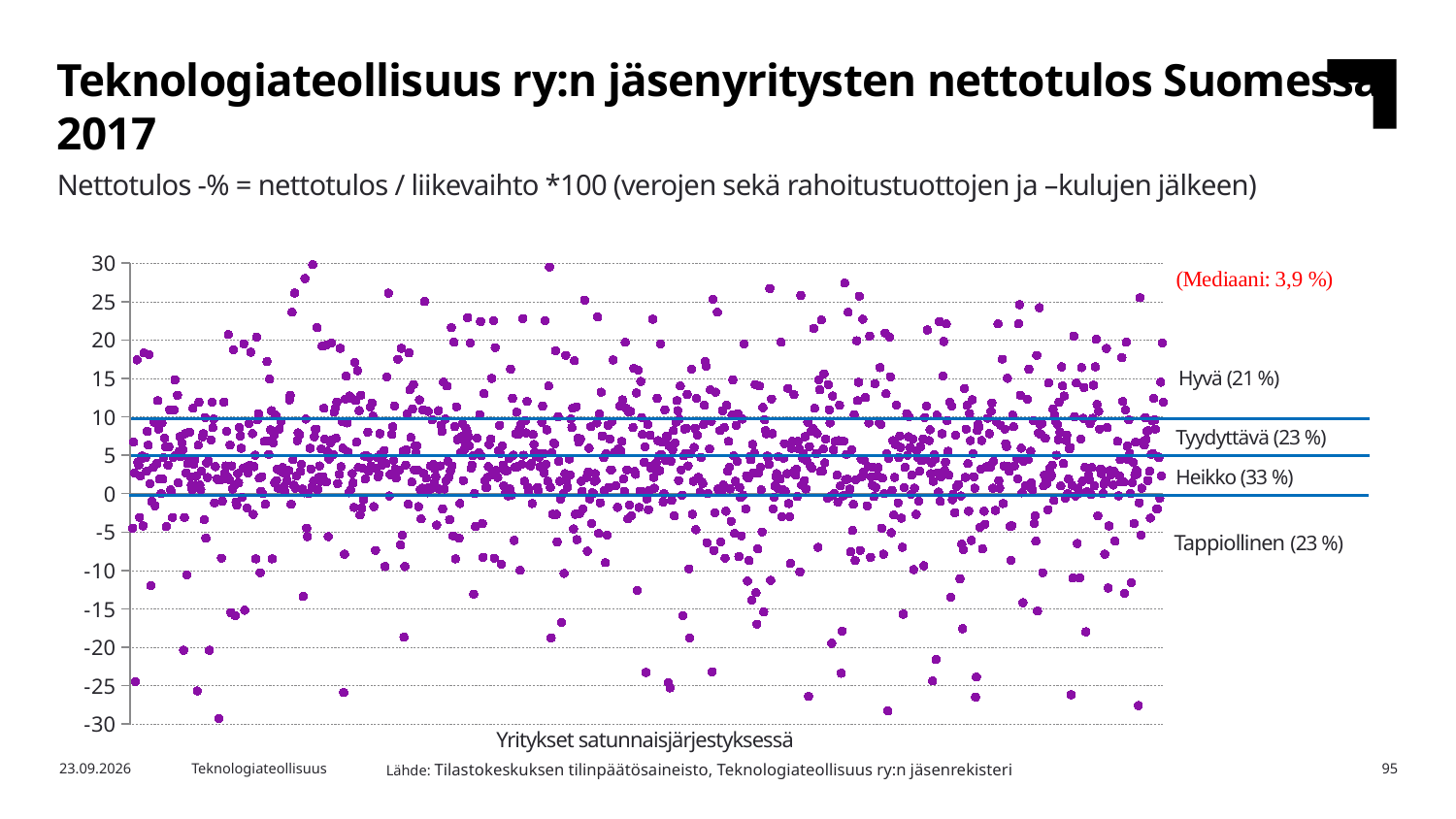
What is the highest value shown on the vertical axis? 30 What share of companies falls into the 'Hyvä' category? 21 % Which category has the smallest share of companies? Hyvä Which category has the largest share of companies? Heikko What kind of chart is shown on the slide? Scatter chart What is the median net profit percentage stated on the chart? 3,9 % What share of companies falls into the 'Tyydyttävä' category? 23 % Which share is larger, 'Heikko' or 'Tappiollinen'? Heikko How many percentage points larger is the 'Heikko' share than the 'Hyvä' share? 12 What share of companies falls into the 'Heikko' category? 33 % What is the label of the horizontal axis? Yritykset satunnaisjärjestyksessä What share of companies falls into the 'Tappiollinen' category? 23 %